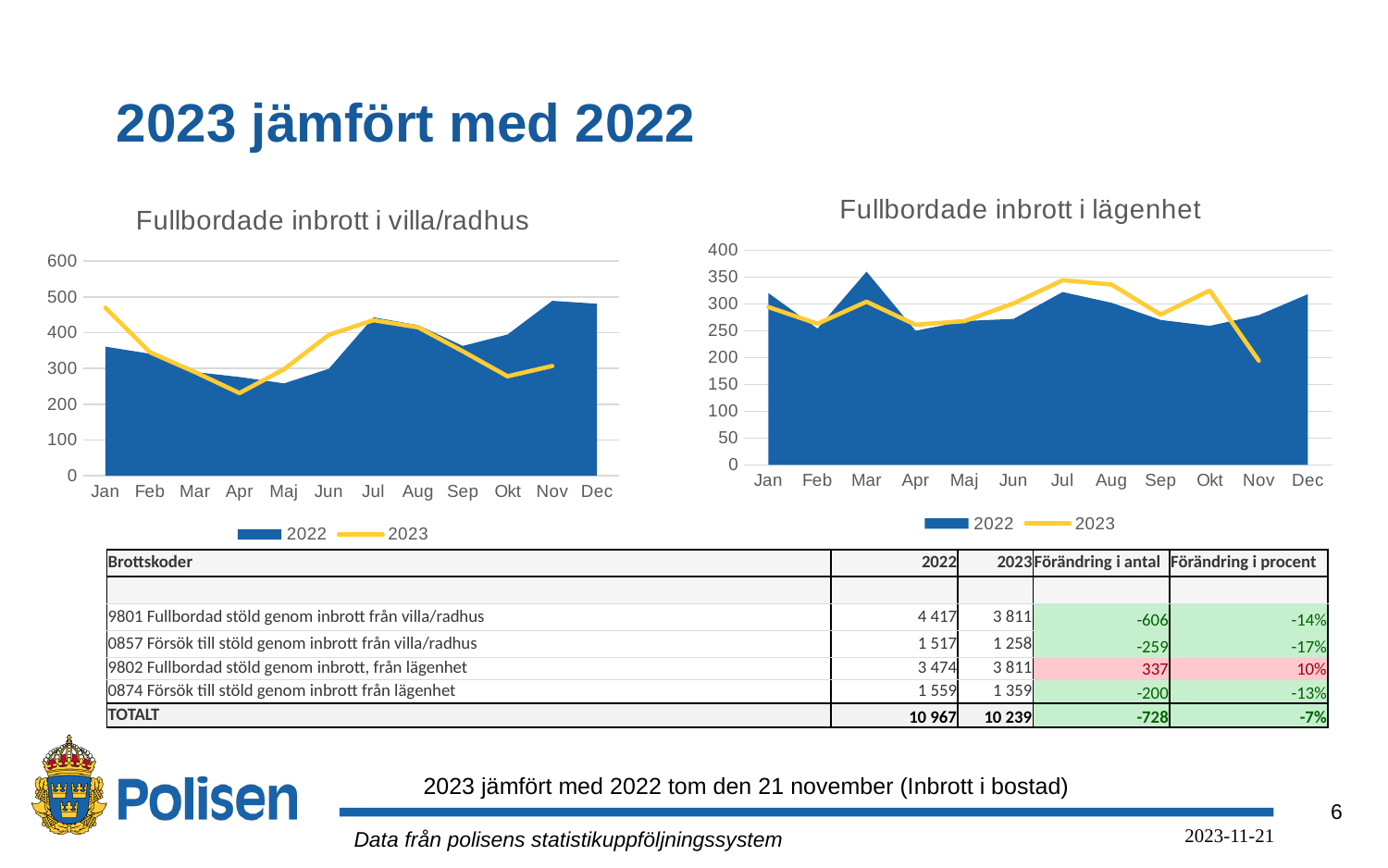
In the chart titled "Fullbordade inbrott i lägenhet", does the 2023 series rise or fall from Okt to Nov? fall In the chart titled "Fullbordade inbrott i lägenhet", is the 2023 value for Nov greater or less than 250? less In the chart titled "Fullbordade inbrott i villa/radhus", which month has the highest value for the 2023 series? Jan In the chart titled "Fullbordade inbrott i villa/radhus", which month has the lowest value for the 2023 series? Apr How many months are shown on the x axis of the chart titled "Fullbordade inbrott i lägenhet"? 12 In the chart titled "Fullbordade inbrott i lägenhet", which month has the highest value for the 2022 series? Mar In the chart titled "Fullbordade inbrott i lägenhet", which month has the lowest value for the 2023 series? Nov In the chart titled "Fullbordade inbrott i villa/radhus", is the 2023 value for Apr greater or less than 300? less In the chart titled "Fullbordade inbrott i villa/radhus", which series has the larger value in Nov, 2022 or 2023? 2022 In the chart titled "Fullbordade inbrott i villa/radhus", which series has the larger value in Jan, 2022 or 2023? 2023 How many series does the legend of the chart titled "Fullbordade inbrott i villa/radhus" list? 2 In the chart titled "Fullbordade inbrott i villa/radhus", is the 2022 value for Nov greater or less than 400? greater